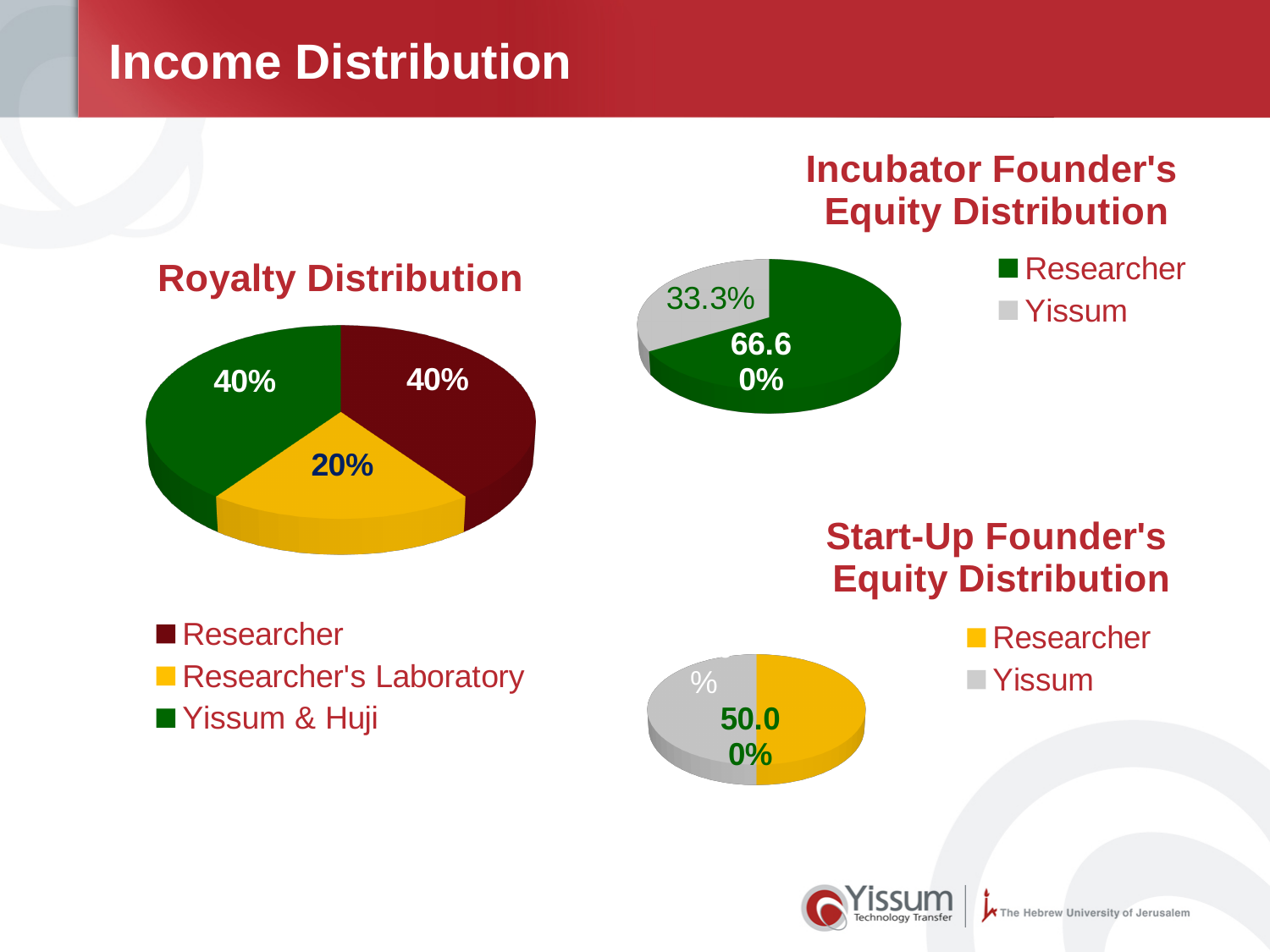
In the Incubator Founder's Equity Distribution chart, which category has the larger share, Researcher or Yissum? Researcher What kind of chart is the Royalty Distribution chart? Pie chart In the Start-Up Founder's Equity Distribution chart, what share goes to the Researcher? 50.00% In the Start-Up Founder's Equity Distribution chart, how many categories does the legend list? 2 In the Incubator Founder's Equity Distribution chart, what colour represents Yissum? Grey In the Royalty Distribution chart, what share goes to Yissum & Huji? 40% In the Royalty Distribution chart, what share goes to the Researcher's Laboratory? 20% In the Royalty Distribution chart, what is the difference between the Researcher share and the Researcher's Laboratory share? 20% In the Royalty Distribution chart, which category has the smallest share? Researcher's Laboratory In the Royalty Distribution chart, how many categories does the legend list? 3 In the Incubator Founder's Equity Distribution chart, what share goes to the Researcher? 66.60% In the Incubator Founder's Equity Distribution chart, what share goes to Yissum? 33.3%